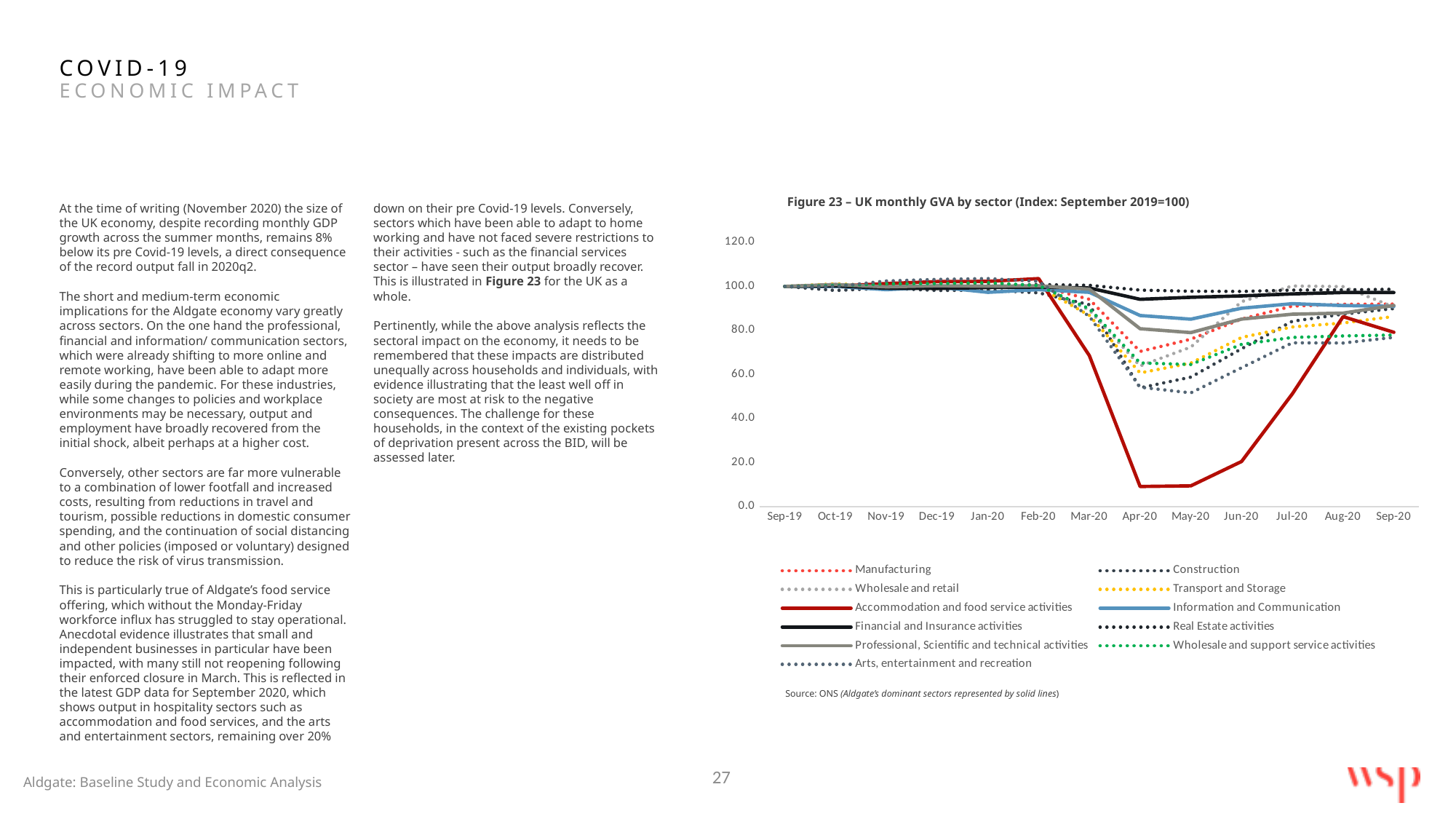
Does the Accommodation and food service activities line rise or fall from Feb-20 to Apr-20? Fall Is the value for Accommodation and food service activities in May-20 greater or less than 20.0? less Which sector has the lowest value in Apr-20? Accommodation and food service activities In May-20, which is larger: Financial and Insurance activities or Accommodation and food service activities? Financial and Insurance activities How many series does the legend of Figure 23 list? 11 Is the value for Accommodation and food service activities in Apr-20 greater or less than 20.0? less Is the value for Financial and Insurance activities in Apr-20 greater or less than 80.0? greater What is the title of the chart? Figure 23 – UK monthly GVA by sector (Index: September 2019=100) According to the note below the chart, what is the source of the data? ONS How many months are shown along the x axis of Figure 23? 13 Which sector has the highest value in Apr-20? Real Estate activities What kind of chart is Figure 23? Line chart